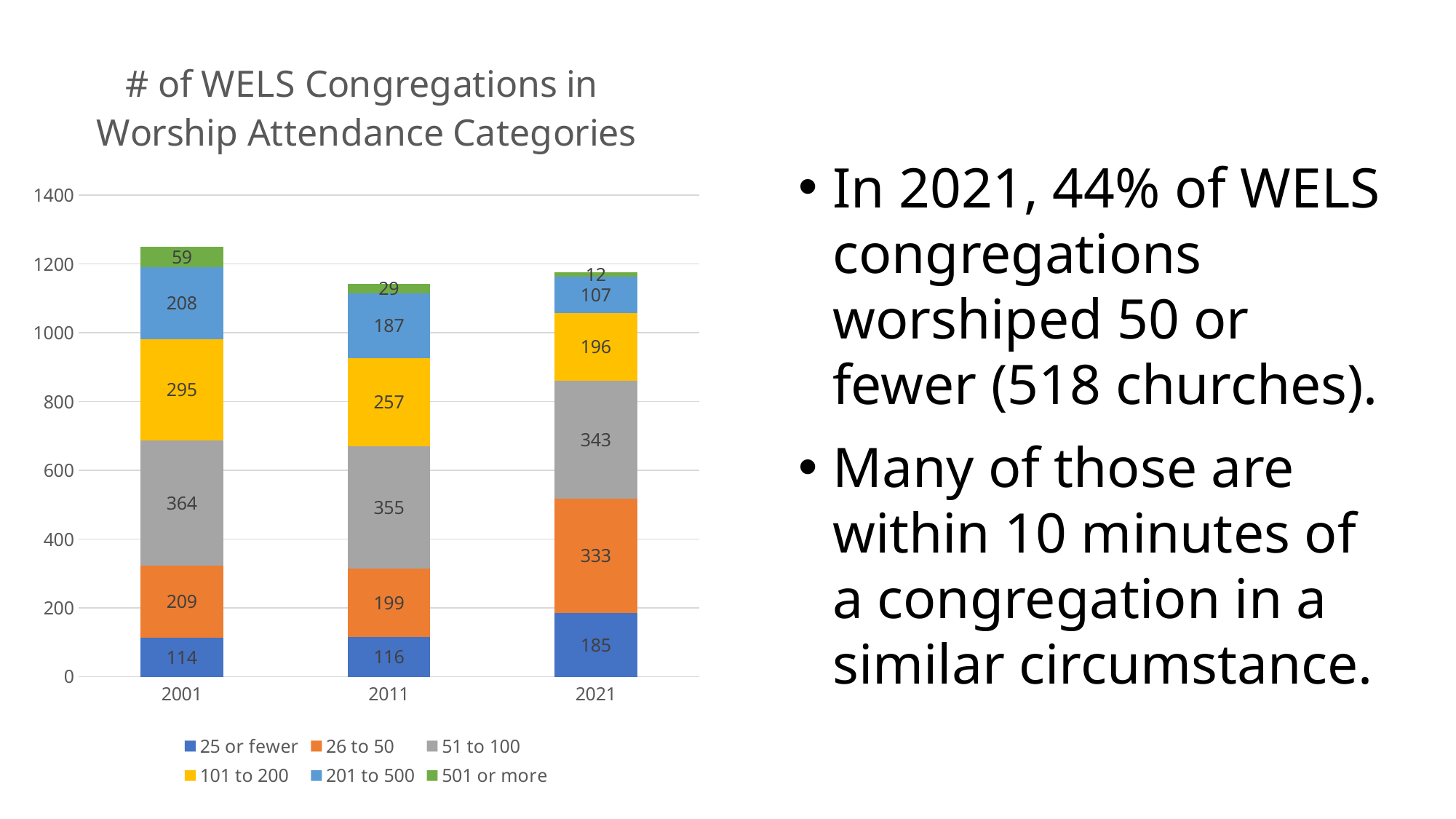
How many years are shown on the x axis? 3 What is the total of the stacked bar for 2011? 1143 What kind of chart is shown on the slide? Stacked bar chart What is the value for the "201 to 500" series in 2011? 187 Which is larger: the "51 to 100" value in 2011 or in 2021? 2011 Which year has the highest value for the "25 or fewer" series? 2021 How many series does the legend list? 6 What is the difference between the "101 to 200" values in 2001 and 2021? 99 What is the title of the chart? # of WELS Congregations in Worship Attendance Categories What is the value for the "501 or more" series in 2001? 59 Which year has the lowest value for the "501 or more" series? 2021 What is the value for the "26 to 50" series in 2021? 333